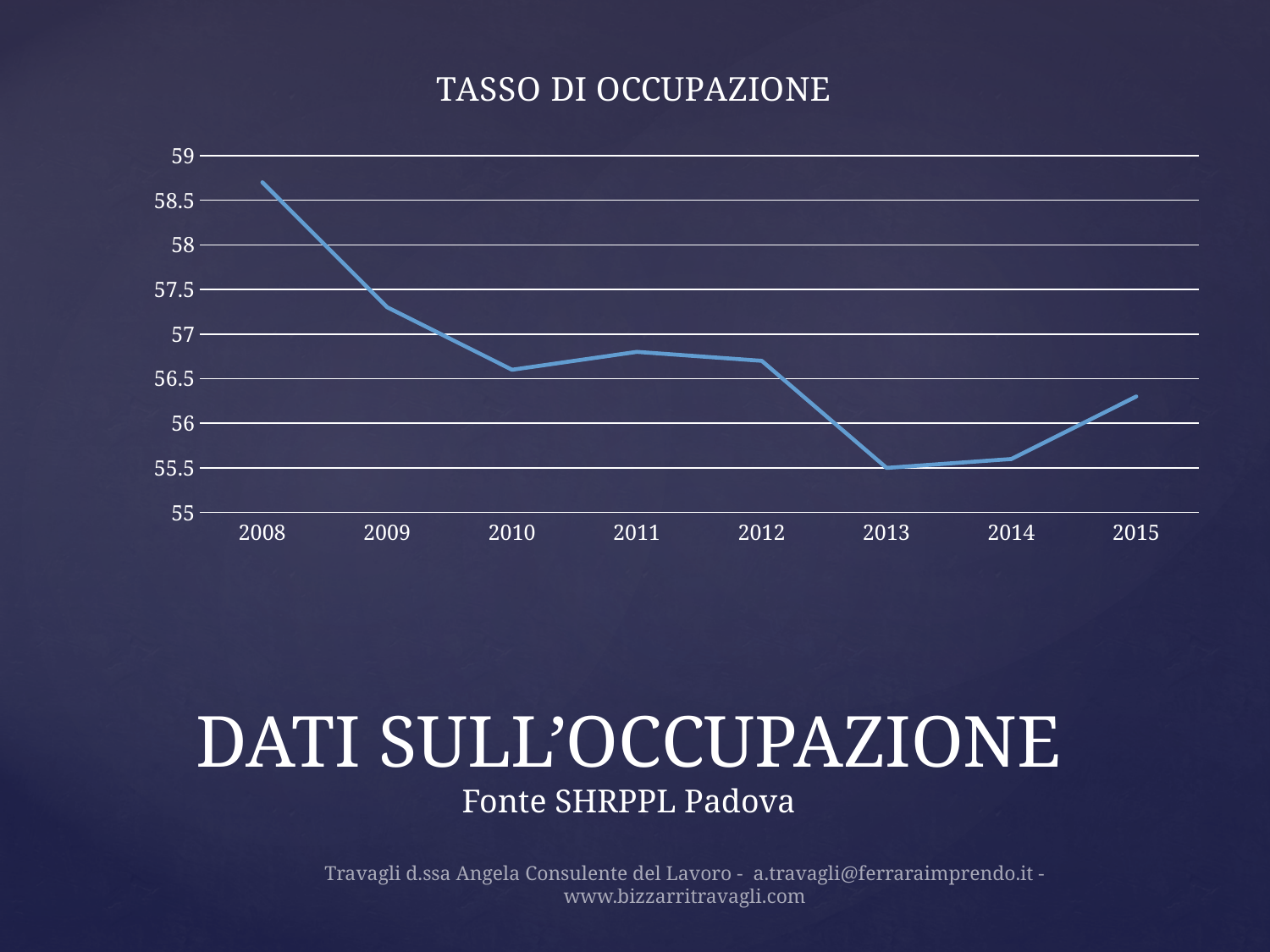
What is the title of the chart? TASSO DI OCCUPAZIONE Is the value for 2008 greater or less than 58.5? greater Is the value for 2009 greater or less than 57.5? less Is the value for 2011 greater or less than 57? less What kind of chart is shown on the slide? line chart How many years are plotted on the x axis of the chart? 8 Which is larger, the value for 2008 or the value for 2015? 2008 Which year has the highest value in the chart? 2008 Which is larger, the value for 2009 or the value for 2012? 2009 Does the value rise or fall from 2008 to 2013? fall